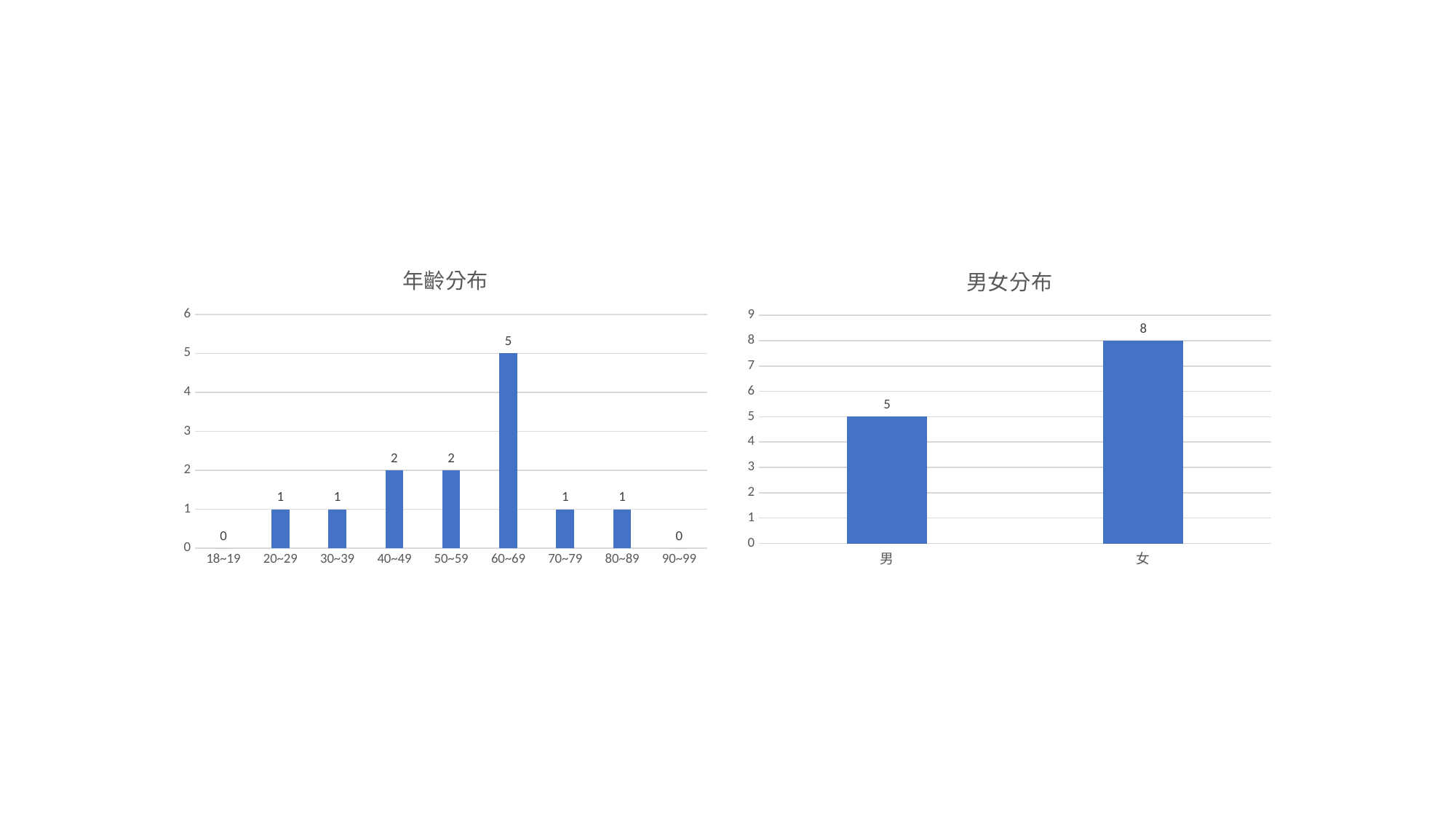
What kind of chart is the 男女分布 chart? bar chart In the 年齢分布 chart, what is the difference between the values for 60~69 and 50~59? 3 In the 年齢分布 chart, which age group has the highest value? 60~69 In the 年齢分布 chart, which is larger, the value for 20~29 or the value for 40~49? 40~49 In the 年齢分布 chart, how many age group categories are shown on the x axis? 9 In the 年齢分布 chart, what is the value for the 60~69 age group? 5 In the 年齢分布 chart, what is the value for the 40~49 age group? 2 In the 男女分布 chart, what is the value for 女? 8 In the 男女分布 chart, what is the value for 男? 5 In the 男女分布 chart, what is the difference between the values for 女 and 男? 3 In the 年齢分布 chart, what is the value for the 90~99 age group? 0 What is the title of the chart on the left side of the slide? 年齡分布